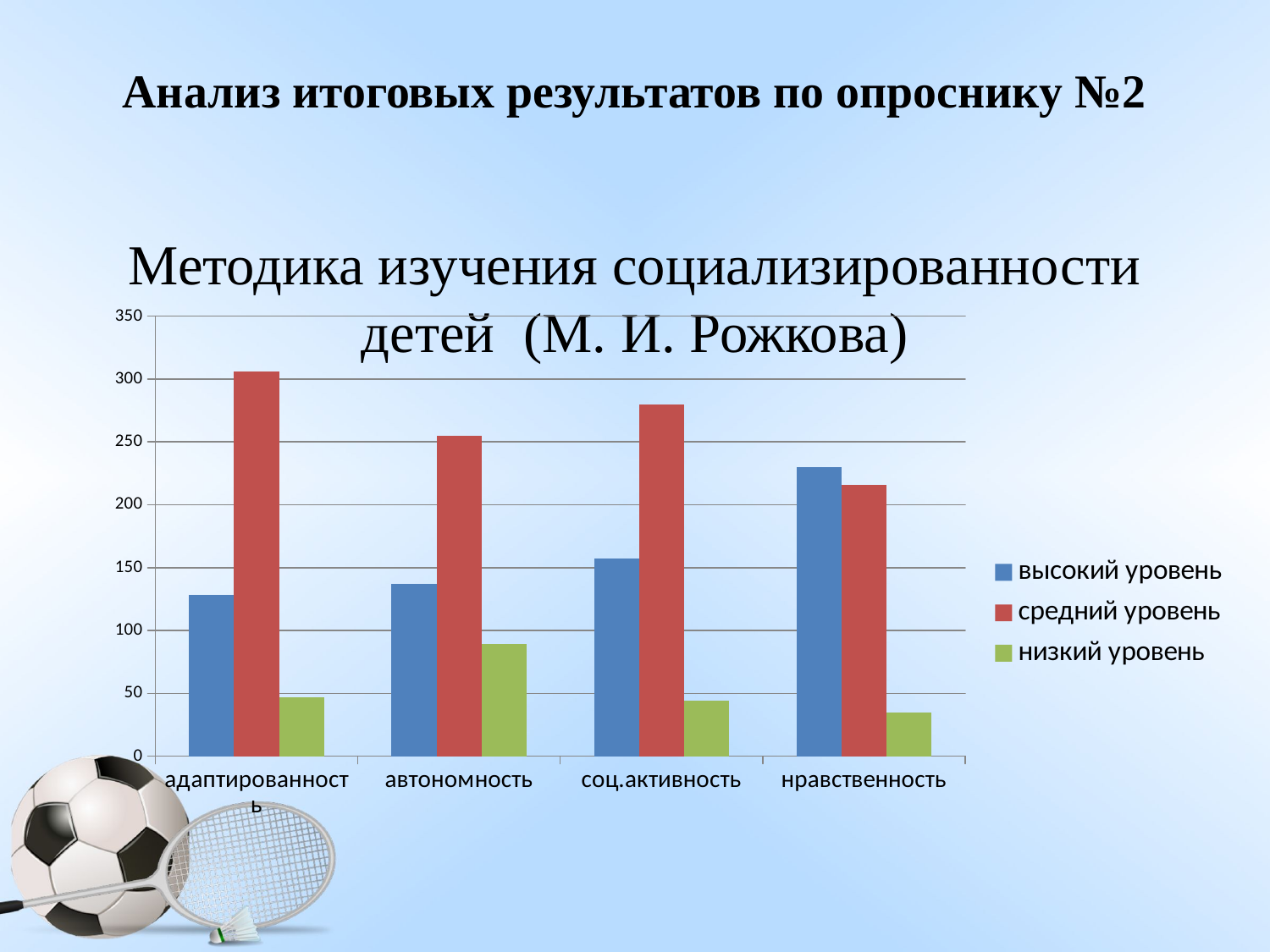
Which category has the highest value for высокий уровень? нравственность Which category has the highest value for низкий уровень? автономность Is the value for высокий уровень in соц.активность greater or less than 200? less Which series is shown in green in the chart legend? низкий уровень How many categories are shown on the x axis of the chart? 4 How many series does the chart legend list? 3 What kind of chart is shown on the slide? bar chart Do the values for высокий уровень rise or fall from адаптированность to нравственность? rise Which category has the highest value for средний уровень? адаптированность Which category has the lowest value for низкий уровень? нравственность Is the value for средний уровень in адаптированность greater or less than 300? greater Which is larger in автономность: высокий уровень or средний уровень? средний уровень